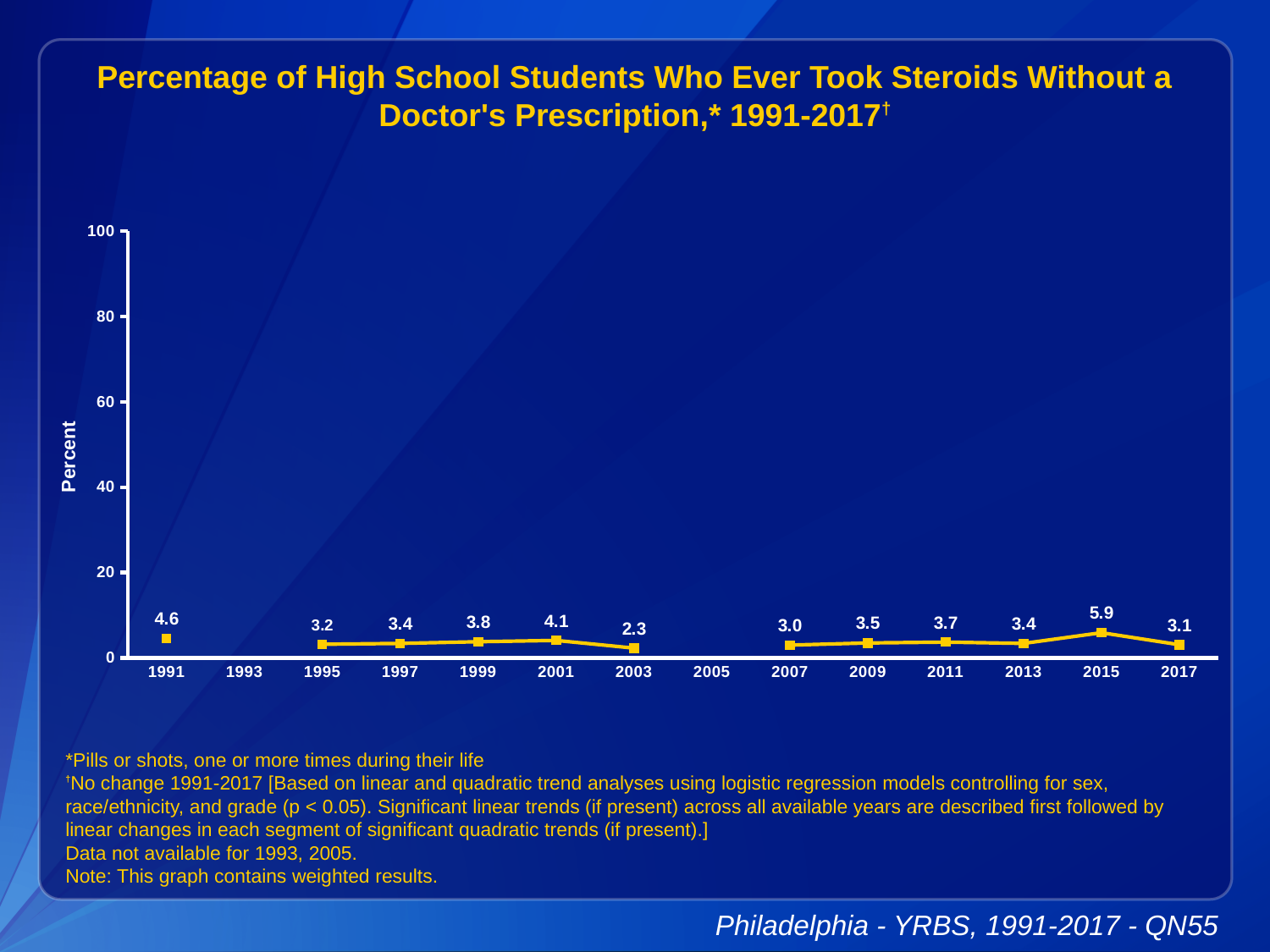
What kind of chart is shown on the slide? Line chart What is the value plotted for 2017? 3.1 Which year has a larger value, 2001 or 2007? 2001 What is the difference between the 2015 value and the 2017 value? 2.8 Which year has the lowest percentage on the chart? 2003 Is the value for 2015 greater or less than 20? less What is the value plotted for 2003? 2.3 Which year has the highest percentage on the chart? 2015 What is the value plotted for 2015? 5.9 How many data points are plotted on the chart? 12 What percentage of high school students reported ever taking steroids without a doctor's prescription in 1991? 4.6 For which years does the chart note that data are not available? 1993, 2005